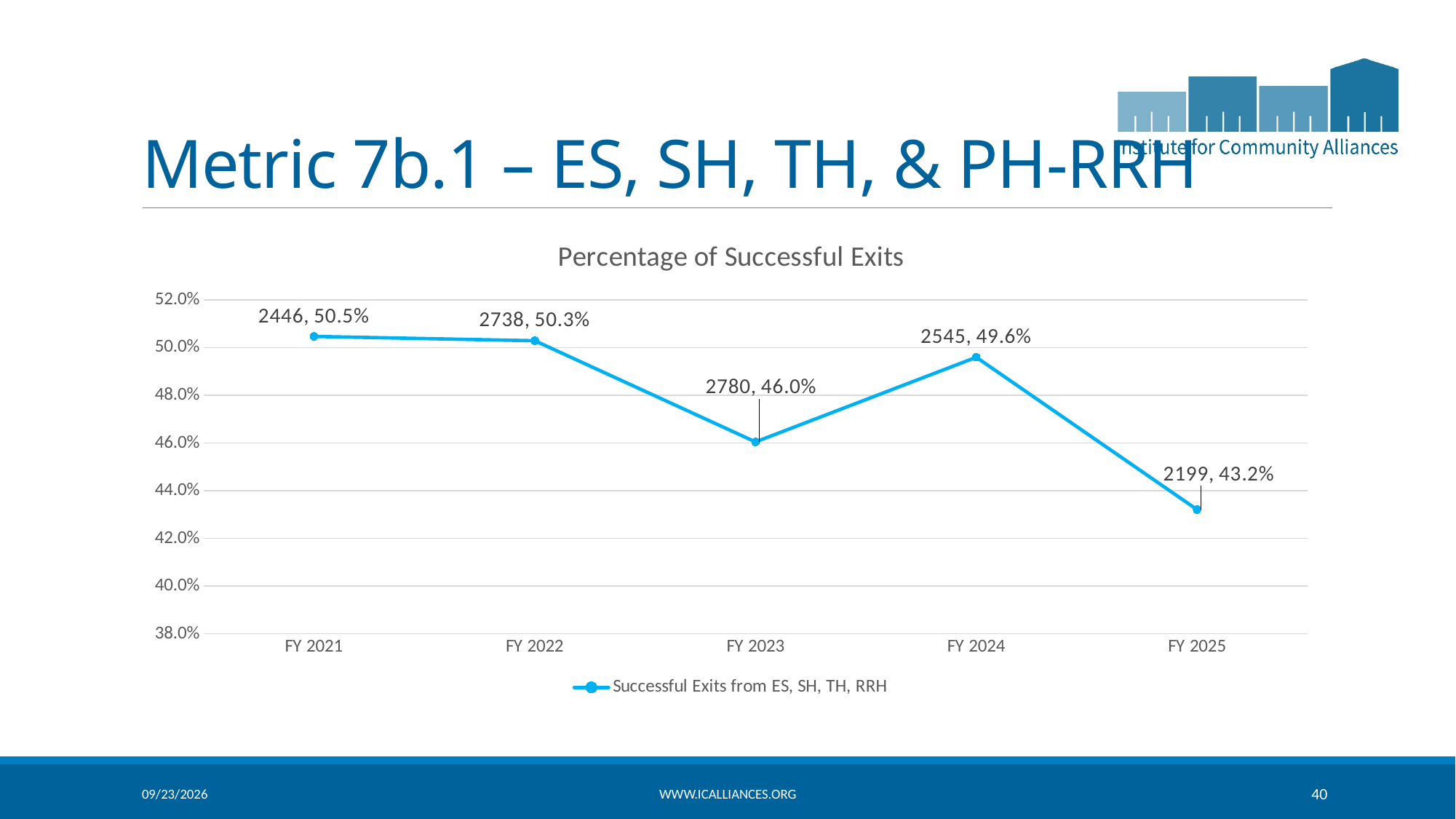
What is the percentage of successful exits for FY 2025? 43.2% Which is larger, the percentage for FY 2023 or FY 2024? FY 2024 Which fiscal year has the highest percentage of successful exits? FY 2021 What is the title of the chart? Percentage of Successful Exits How many series does the legend list? 1 How many fiscal years are plotted on the chart? 5 What is the difference in percentage points between FY 2024 and FY 2025? 6.4 What is the percentage of successful exits for FY 2023? 46.0% What kind of chart is shown on the slide? line chart What count is shown in the data label for FY 2022? 2738 Is the value for FY 2025 greater or less than 44.0%? less Which fiscal year has the lowest percentage of successful exits? FY 2025